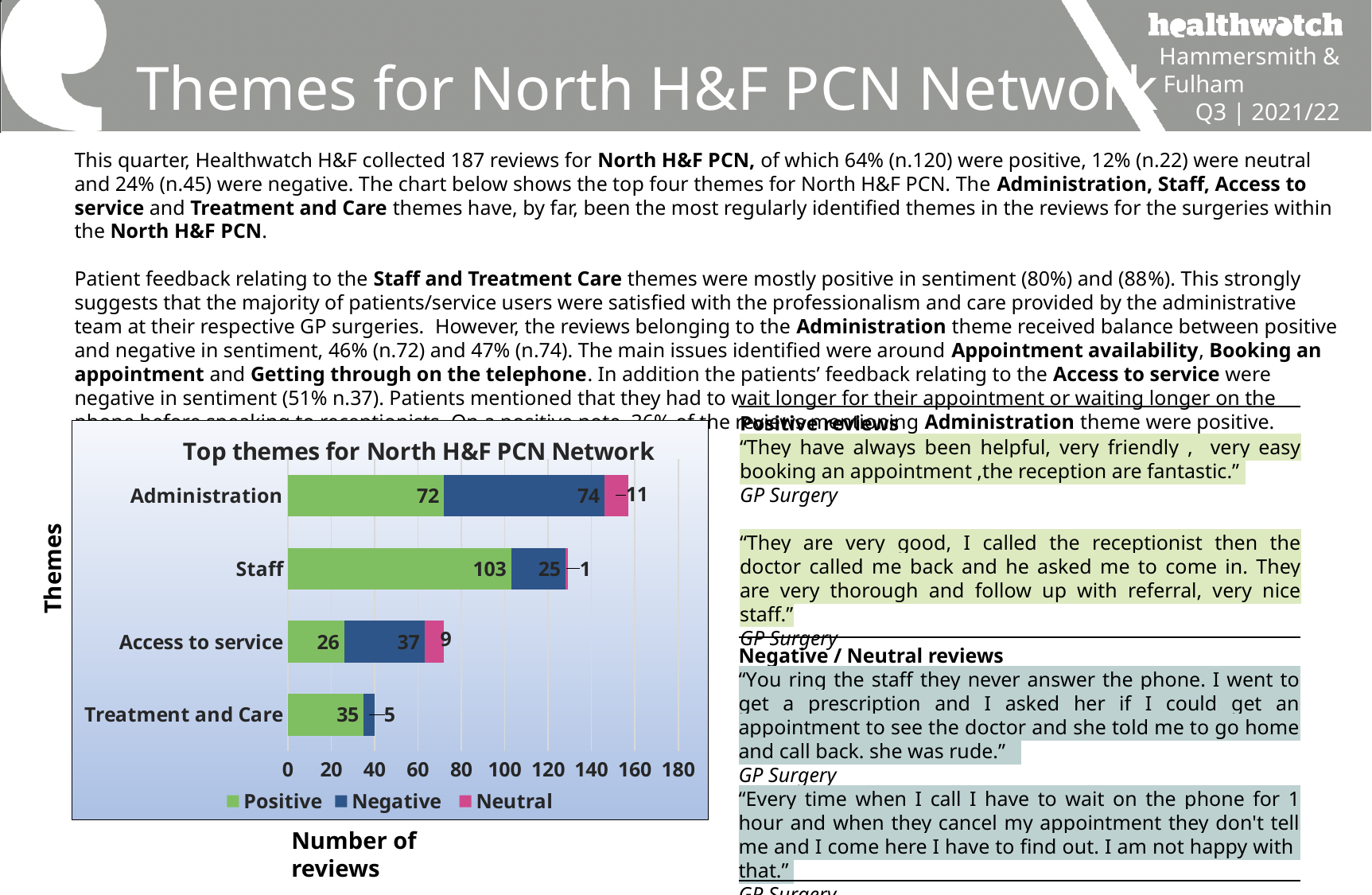
Which theme has the lowest Negative value? Treatment and Care What is the Negative value for Treatment and Care? 5 What is the total number of reviews in the Administration bar? 157 Is the Positive value for Administration larger or smaller than the Positive value for Staff? Smaller What is the Negative value for Administration? 74 How many themes are plotted in the chart? 4 Which theme has the highest Positive value? Staff What is the Neutral value for Access to service? 9 What is the difference between the Positive and Negative values for Access to service? 11 What kind of chart is shown on the slide? Stacked bar chart What is the Positive value for Staff? 103 How many series does the chart legend list? 3